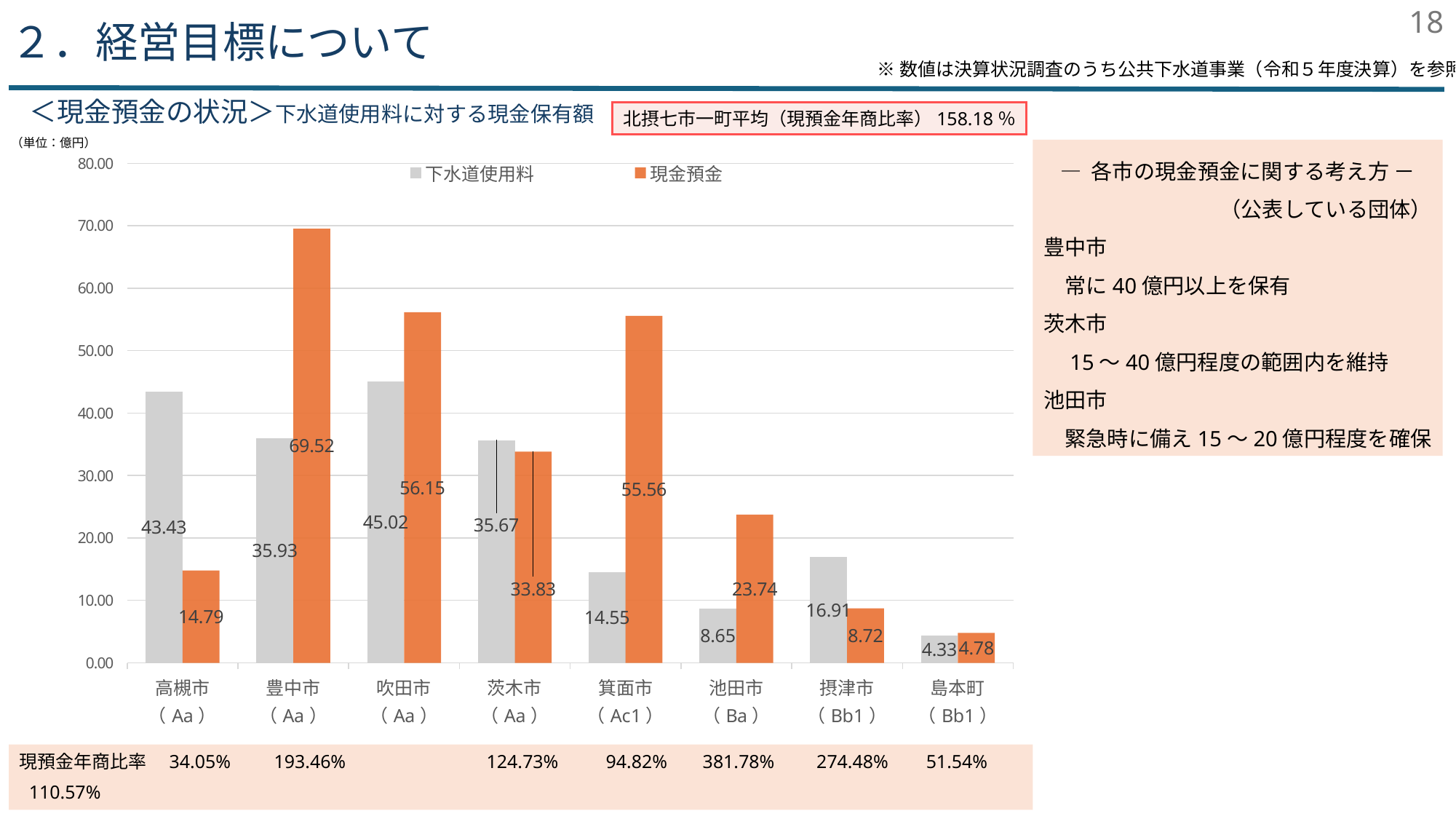
For 摂津市, which is larger: 下水道使用料 or 現金預金? 下水道使用料 How many municipalities are shown on the x axis of the chart? 8 What is the 現金預金 value for 豊中市? 69.52 Is the 現金預金 value for 池田市 greater or less than 20.00? greater What kind of chart is shown on the slide? bar chart Which series is shown in orange in the chart? 現金預金 Which municipality has the highest 現金預金 value? 豊中市 What is the 下水道使用料 value for 吹田市? 45.02 Which municipality has the lowest 下水道使用料 value? 島本町 What is the difference between the 現金預金 and 下水道使用料 values for 高槻市? 28.64 What is the 現金預金 value for 箕面市? 55.56 How many series does the chart legend list? 2